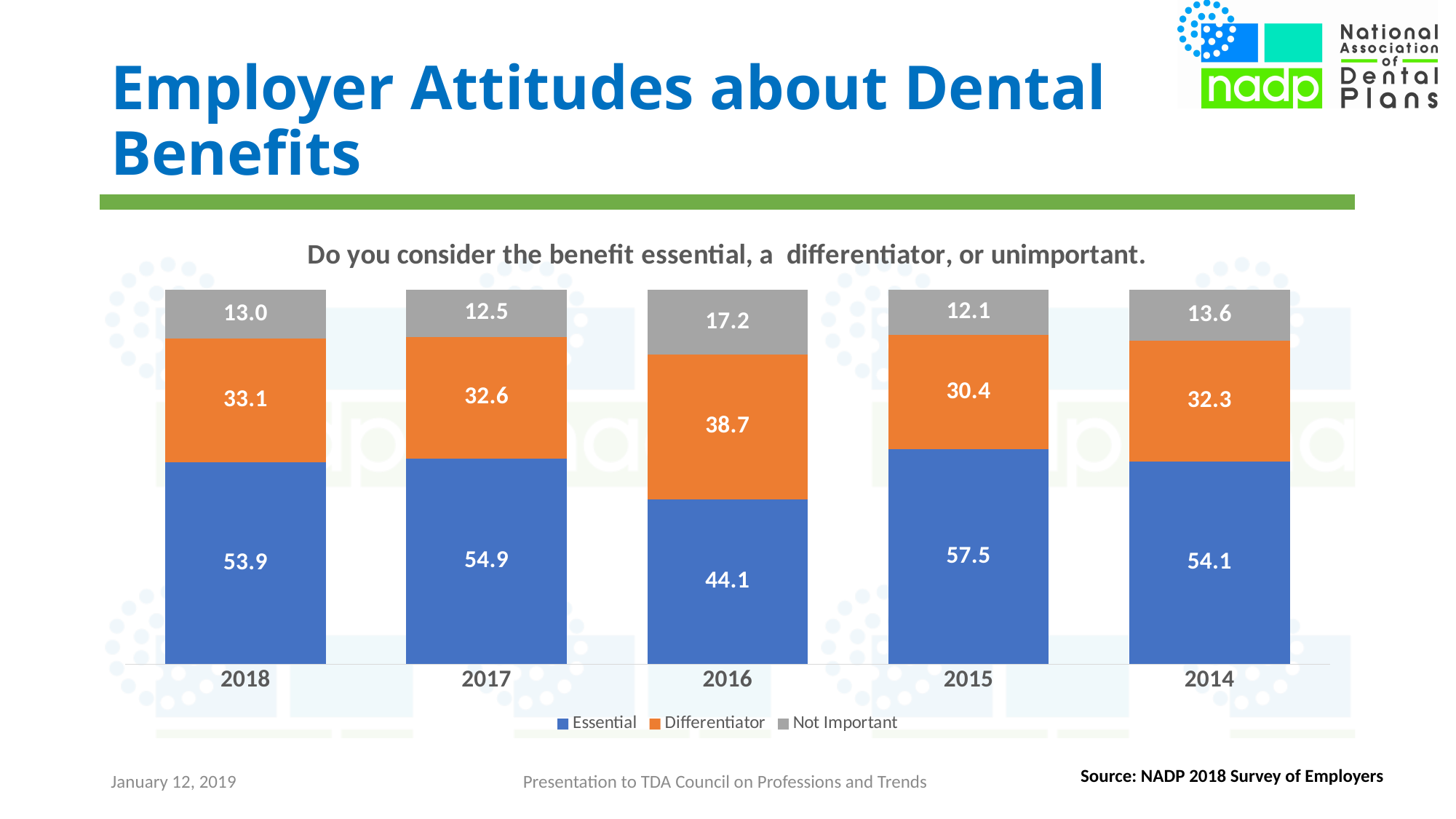
Which year has the lowest Essential value? 2016 What is the total of the stacked bar for 2017? 100.0 Which year has the highest Essential value? 2015 What is the Not Important value for 2014? 13.6 What is the Essential value for 2016? 44.1 What is the difference between the Essential values for 2015 and 2016? 13.4 How many series does the legend list? 3 How many years are shown on the x axis? 5 Which year has the highest Not Important value? 2016 What kind of chart is shown on the slide? Stacked bar chart What is the Differentiator value for 2015? 30.4 Which is larger, the Differentiator value for 2018 or for 2017? 2018